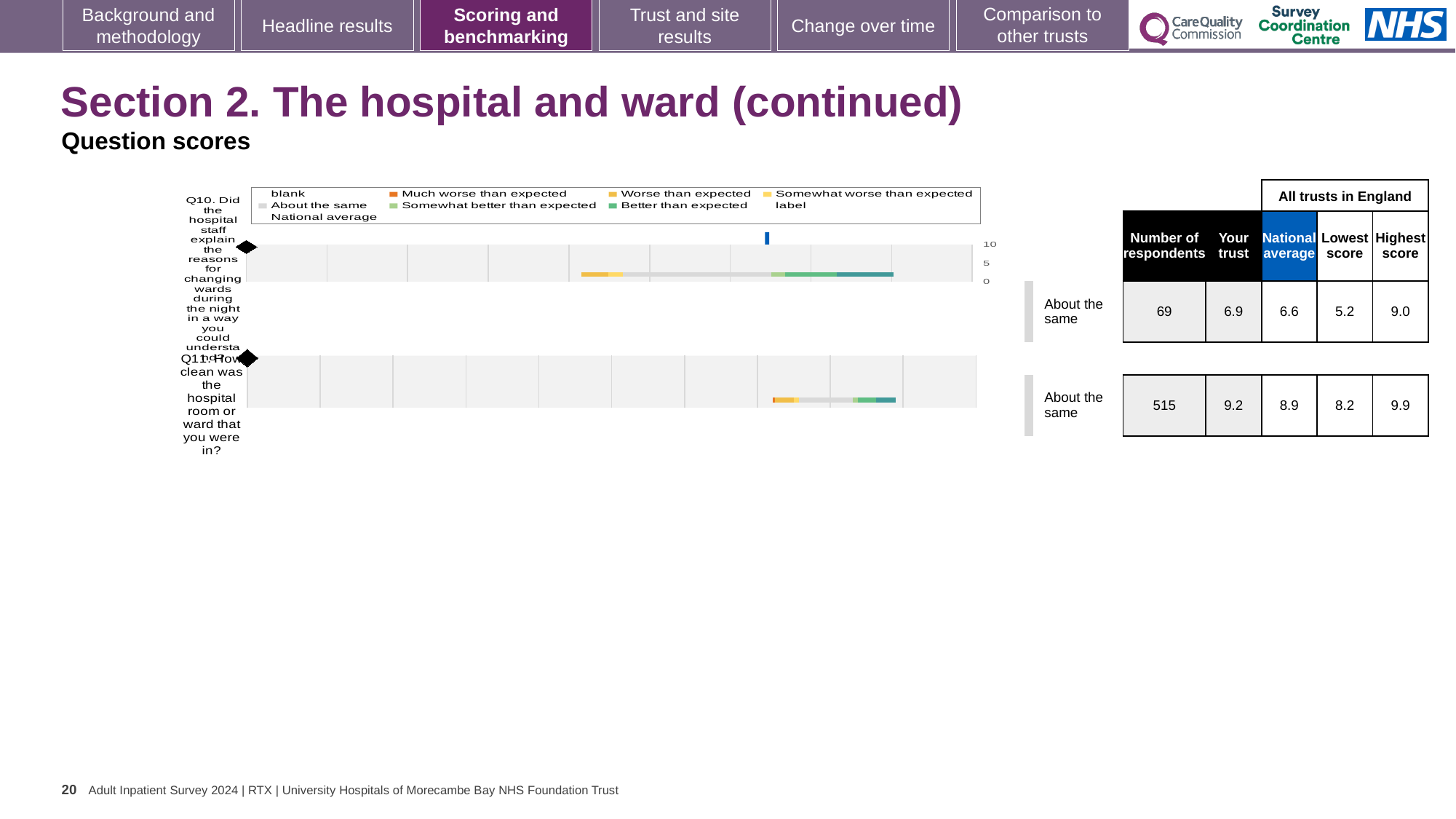
For the Q10 chart (explaining reasons for changing wards during the night), what is the number of respondents shown in the table? 69 For the Q11 chart (how clean was the hospital room or ward), what is the 'Your trust' score? 9.2 For the Q10 chart, what is the 'Your trust' score? 6.9 For the Q11 chart, what is the highest score among all trusts in England? 9.9 What kind of chart is used to show the question scores for Q10 and Q11? Bar chart In the chart legend, what colour represents 'Much worse than expected'? Orange What benchmark category is shown next to the Q10 chart? About the same For the Q10 chart, what is the national average score? 6.6 For the Q11 chart, what is the lowest score among all trusts in England? 8.2 How many survey questions are charted on the slide? 2 For the Q11 chart, which is larger: the 'Your trust' score or the national average? Your trust For the Q10 chart, what is the difference between the highest score (9.0) and the lowest score (5.2)? 3.8